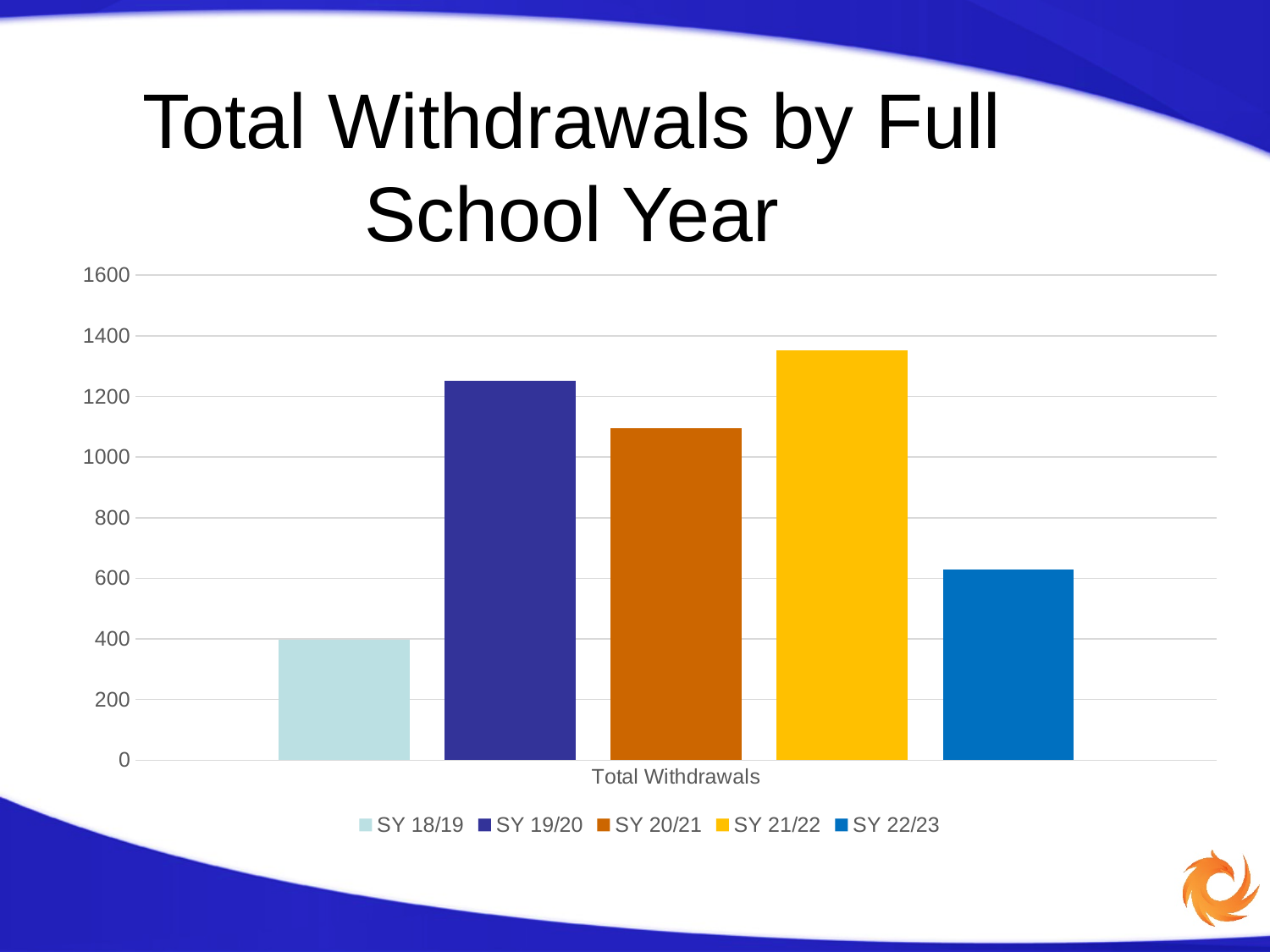
What kind of chart is shown on the slide? Bar chart Is the value for SY 20/21 greater or less than 1000? greater Which school year has the highest total withdrawals? SY 21/22 Which school year has the lowest total withdrawals? SY 18/19 Is the value for SY 19/20 greater or less than 1400? less Is the value for SY 22/23 greater or less than 800? less How many series does the legend list? 5 Which has more total withdrawals, SY 19/20 or SY 20/21? SY 19/20 Which has more total withdrawals, SY 22/23 or SY 18/19? SY 22/23 What is the title of the chart? Total Withdrawals by Full School Year What colour is the bar for SY 21/22? Yellow